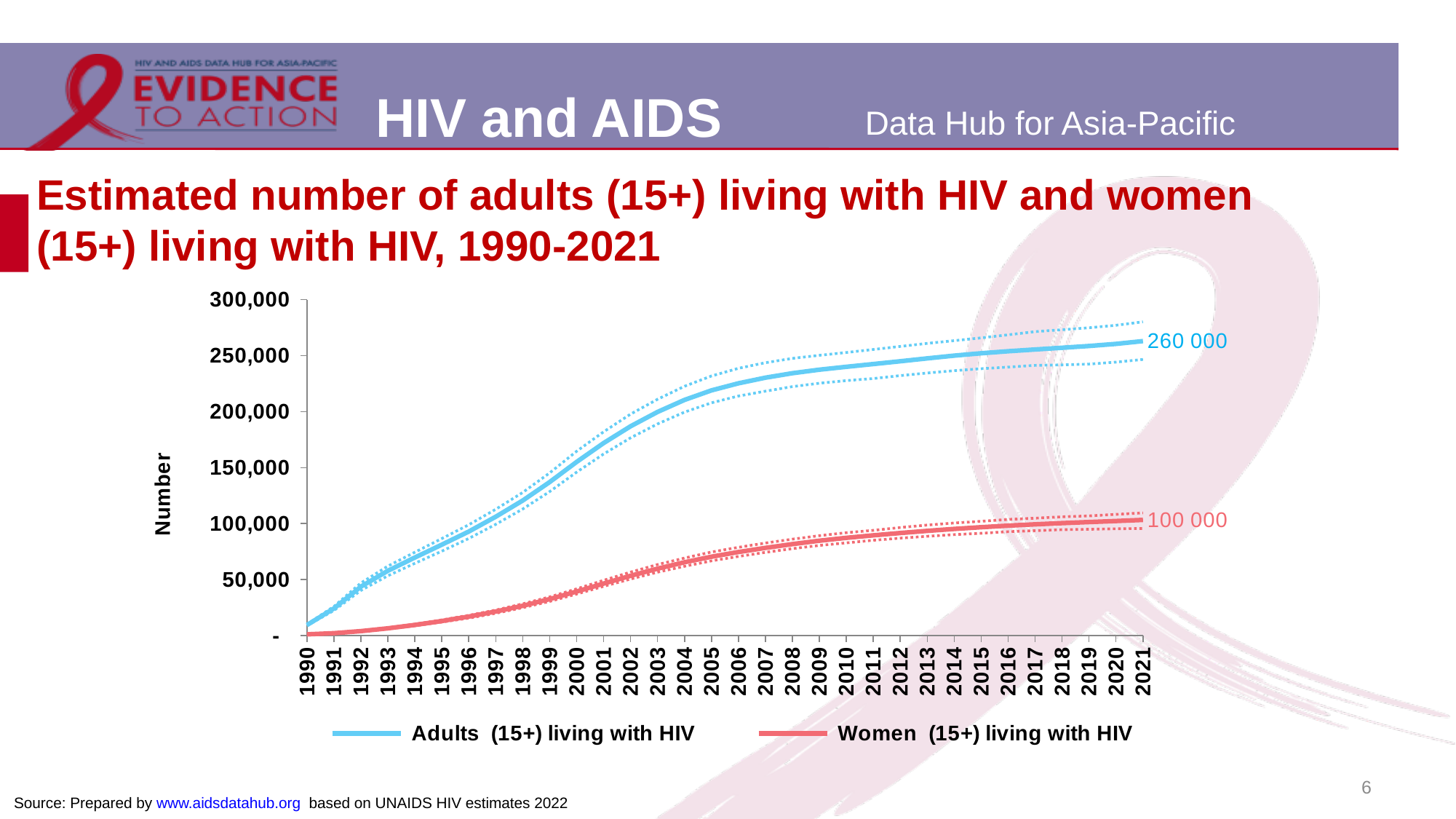
Is the value for Adults (15+) living with HIV in 2005 greater or less than 200,000? greater Does the number of Adults (15+) living with HIV rise or fall from 1990 to 2021? rise What kind of chart is shown on the slide? line chart What is the labelled value for Adults (15+) living with HIV in 2021? 260 000 What is the labelled value for Women (15+) living with HIV in 2021? 100 000 Is the value for Women (15+) living with HIV in 2010 greater or less than 100,000? less What is the difference between the 2021 values for Adults (15+) living with HIV and Women (15+) living with HIV? 160 000 What is the title of the chart's y axis? Number Is the value for Adults (15+) living with HIV in 1990 greater or less than 50,000? less How many years are shown on the x axis of the chart? 32 How many series does the chart legend list? 2 In 2021, which series has the larger value: Adults (15+) living with HIV or Women (15+) living with HIV? Adults (15+) living with HIV